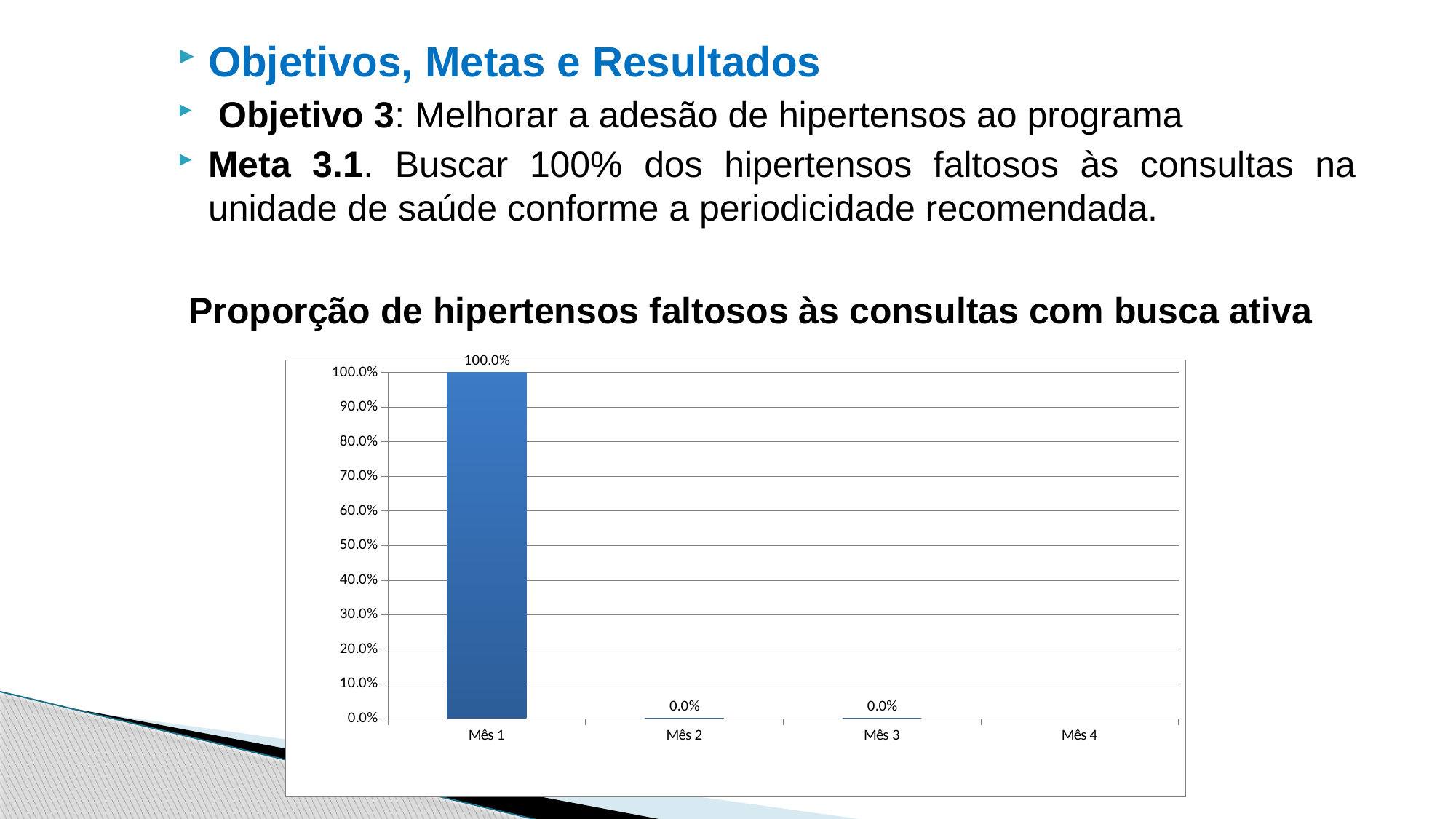
What is the value for Mês 3 in the chart? 0.0% What is the highest tick value shown on the y axis of the chart? 100.0% Do the values rise or fall from Mês 1 to Mês 3? fall Which is larger, the value for Mês 1 or the value for Mês 3? Mês 1 How many months are shown on the x axis of the chart? 4 Is the value for Mês 1 greater or less than 50.0%? greater Which month has the highest value in the chart? Mês 1 What is the value for Mês 1 in the chart? 100.0% What is the difference between the values for Mês 1 and Mês 2? 100.0% What is the title of the chart? Proporção de hipertensos faltosos às consultas com busca ativa What kind of chart is shown on the slide? bar chart What is the value for Mês 2 in the chart? 0.0%